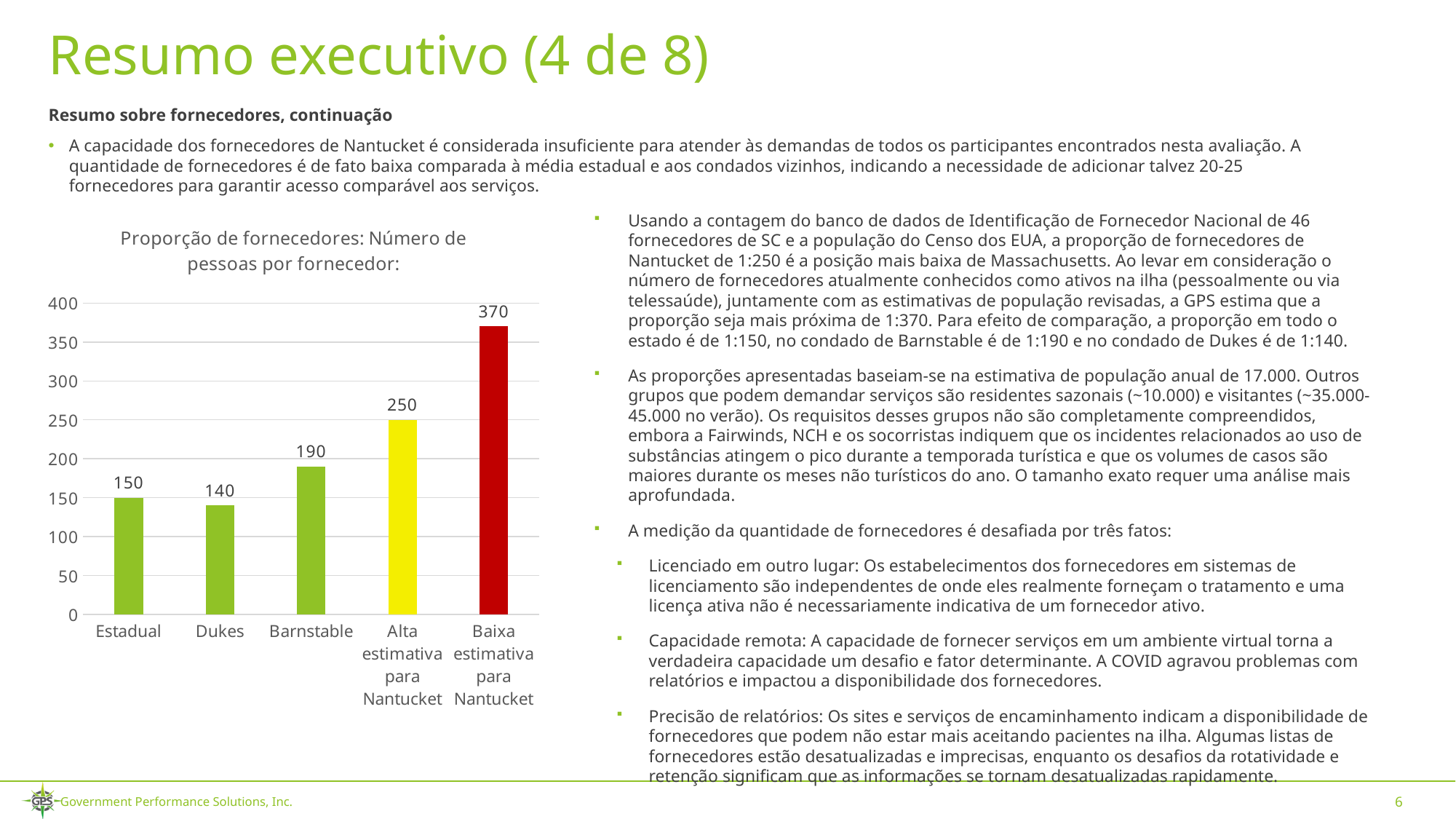
What is the value for Barnstable? 190 Which is larger, the value for Barnstable or the value for Estadual? Barnstable Which category has the lowest value? Dukes What is the title of the chart? Proporção de fornecedores: Número de pessoas por fornecedor: Which category has the highest value? Baixa estimativa para Nantucket What is the value for Estadual? 150 What is the value for Dukes? 140 What is the value for Alta estimativa para Nantucket? 250 How many categories are shown in the chart? 5 What is the difference between the values for Baixa estimativa para Nantucket and Alta estimativa para Nantucket? 120 What kind of chart is shown on the slide? bar chart Is the value for Baixa estimativa para Nantucket greater or less than 350? greater